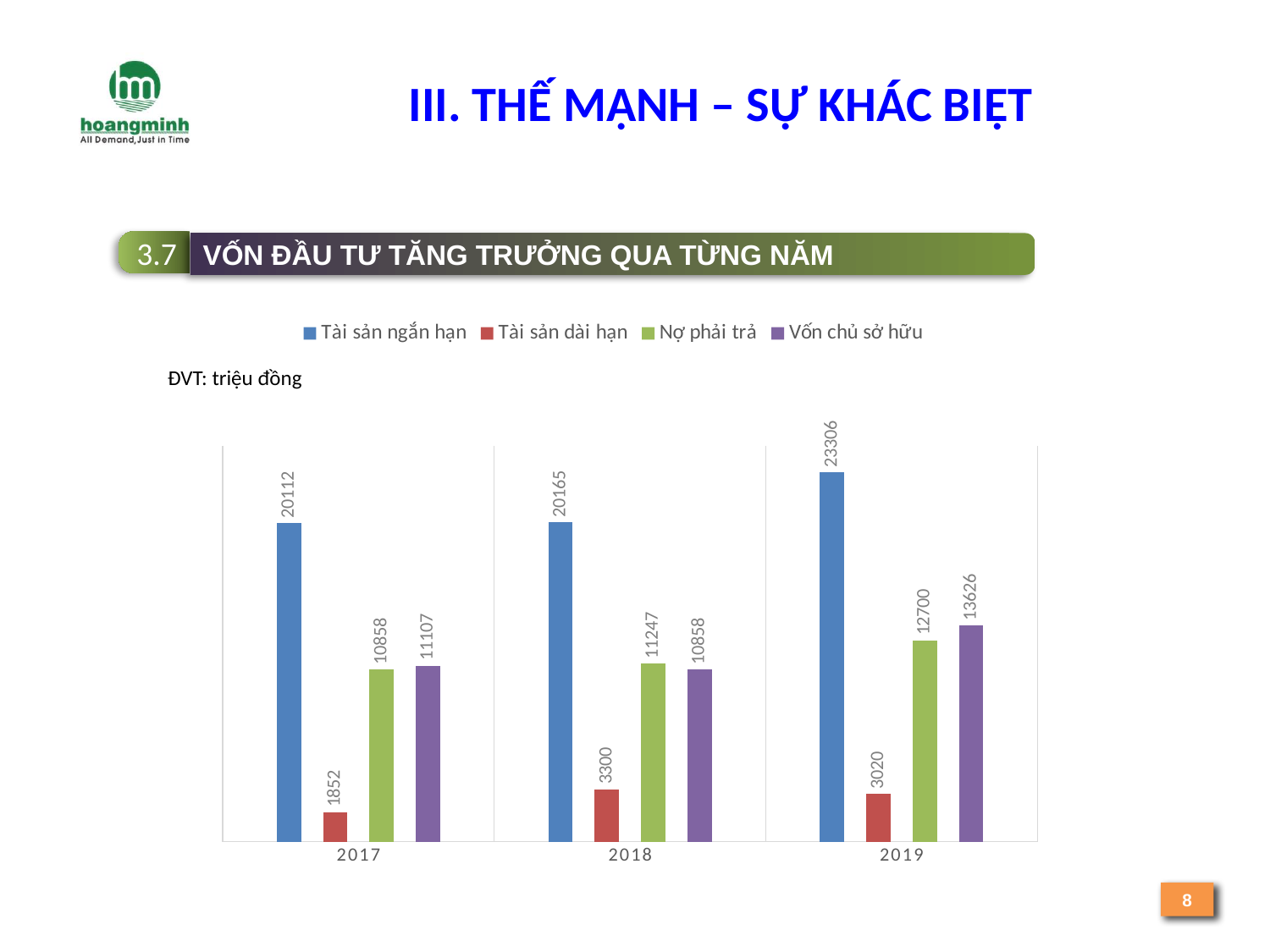
How many years are shown on the x axis? 3 What is the value of Tài sản ngắn hạn in 2019? 23306 What kind of chart is shown? Bar chart What is the value of Nợ phải trả in 2018? 11247 Which is larger in 2018: Nợ phải trả or Vốn chủ sở hữu? Nợ phải trả Does Vốn chủ sở hữu rise or fall from 2017 to 2019? Rise How many series does the legend list? 4 What is the value of Tài sản dài hạn in 2017? 1852 In which year is Tài sản ngắn hạn highest? 2019 What is the value of Vốn chủ sở hữu in 2019? 13626 What is the difference between Tài sản ngắn hạn in 2019 and in 2018? 3141 In which year is Tài sản dài hạn lowest? 2017